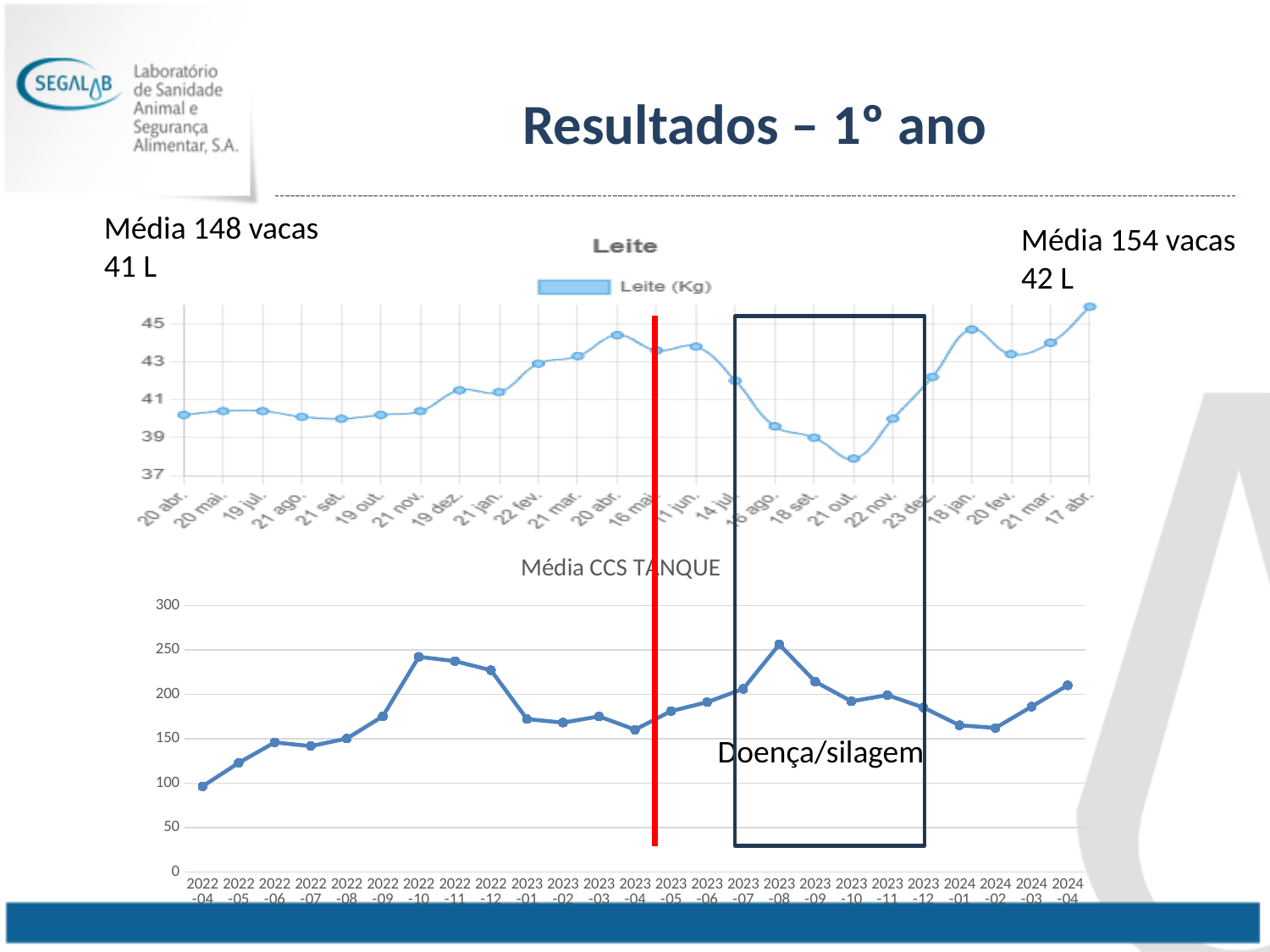
In the "Média CCS TANQUE" chart, which month has the highest value? 2023-08 What is the legend entry of the "Leite" chart? Leite (Kg) In the "Leite" chart, do the values rise or fall from 14 jul. to 21 out.? fall In the "Leite" chart, is the value for 17 abr. greater or less than 45? greater In the "Média CCS TANQUE" chart, how many data points are plotted? 25 What kind of chart is the top chart titled "Leite"? line chart How many series does the legend of the "Leite" chart list? 1 In the "Média CCS TANQUE" chart, which month has the lowest value? 2022-04 In the "Leite" chart, is the value for 21 out. greater or less than 39? less In the "Leite" chart, which date has the highest value? 17 abr. In the "Leite" chart, which date has the lowest value? 21 out. In the "Média CCS TANQUE" chart, is the value for 2023-08 greater or less than 250? greater